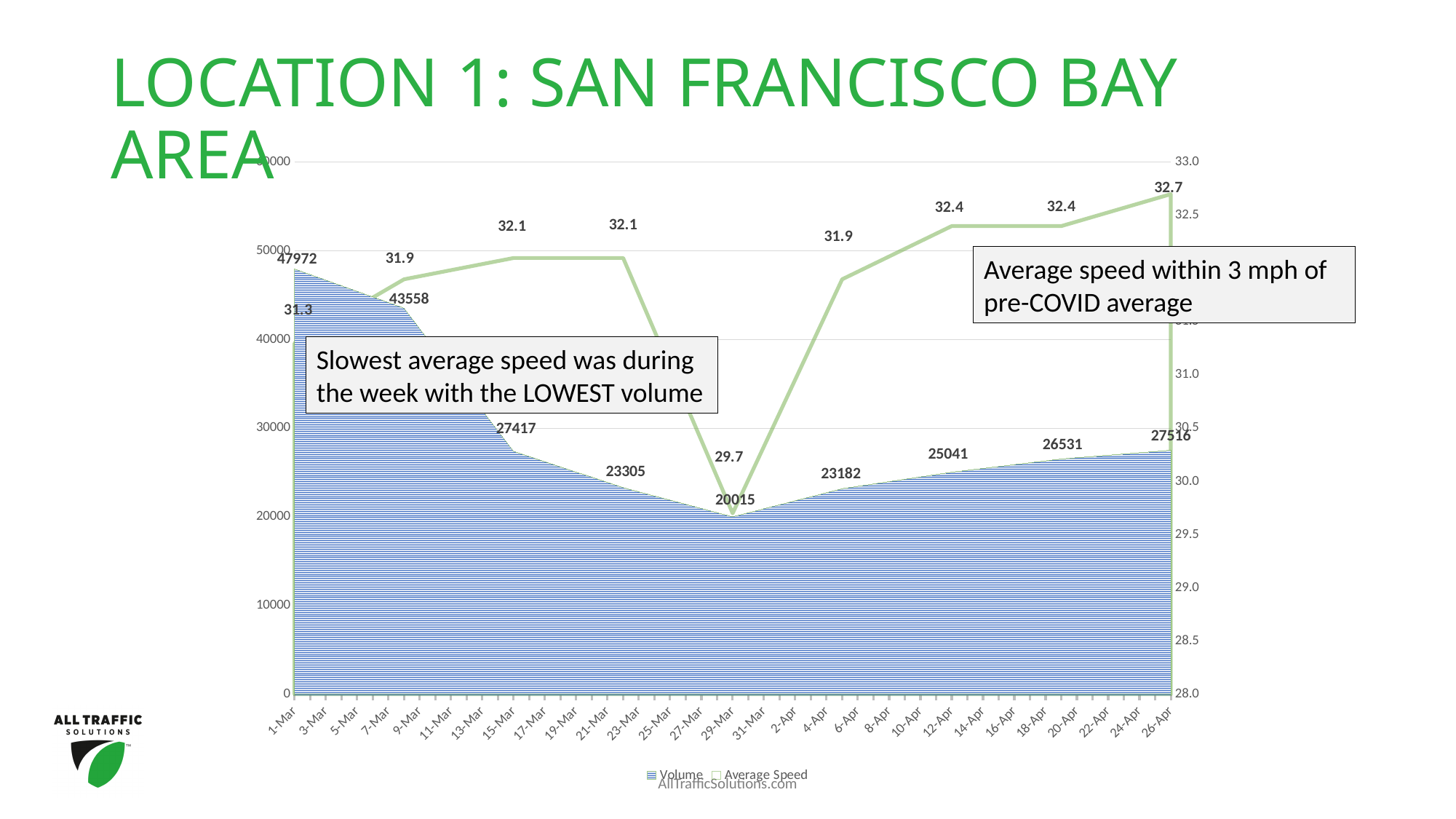
Which series is plotted as a green line? Average Speed Which is larger, the Volume on 1-Mar or the Volume on 26-Apr? 1-Mar What is the highest Volume value shown on the chart? 47972 What is the highest Average Speed value shown on the chart? 32.7 What is the Average Speed value on 26-Apr? 32.7 What is the lowest Volume value shown on the chart? 20015 Does the Volume rise or fall from 29-Mar to 26-Apr? rise What is the difference between the highest and lowest Volume values? 27957 What is the Volume value on 29-Mar? 20015 How many series does the legend list? 2 What is the lowest Average Speed value shown on the chart? 29.7 What is the Volume value on 1-Mar? 47972